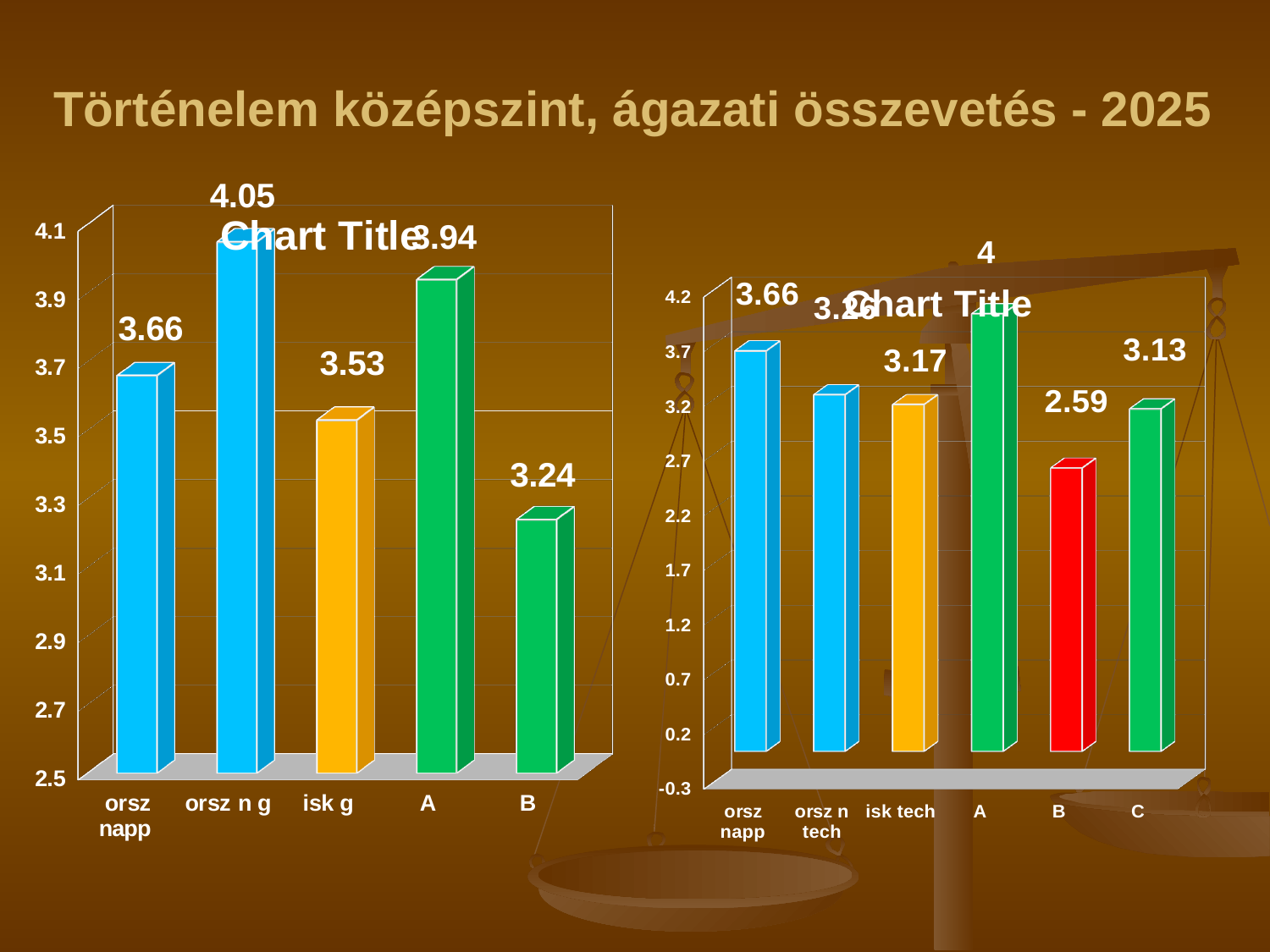
On the left chart, which category has the lowest value? B What kind of chart is the right chart? bar chart On the right chart, which category has the lowest value? B On the right chart, how many categories are shown on the x axis? 6 On the left chart, what is the difference between the values for orsz n g and isk g? 0.52 On the right chart, which is larger, the value for isk tech or the value for C? isk tech On the left chart, what is the value for B? 3.24 On the left chart, which category has the highest value? orsz n g On the left chart, what is the value for orsz n g? 4.05 On the left chart, how many categories are shown on the x axis? 5 On the right chart, what is the value for A? 4 On the right chart, what is the value for B? 2.59